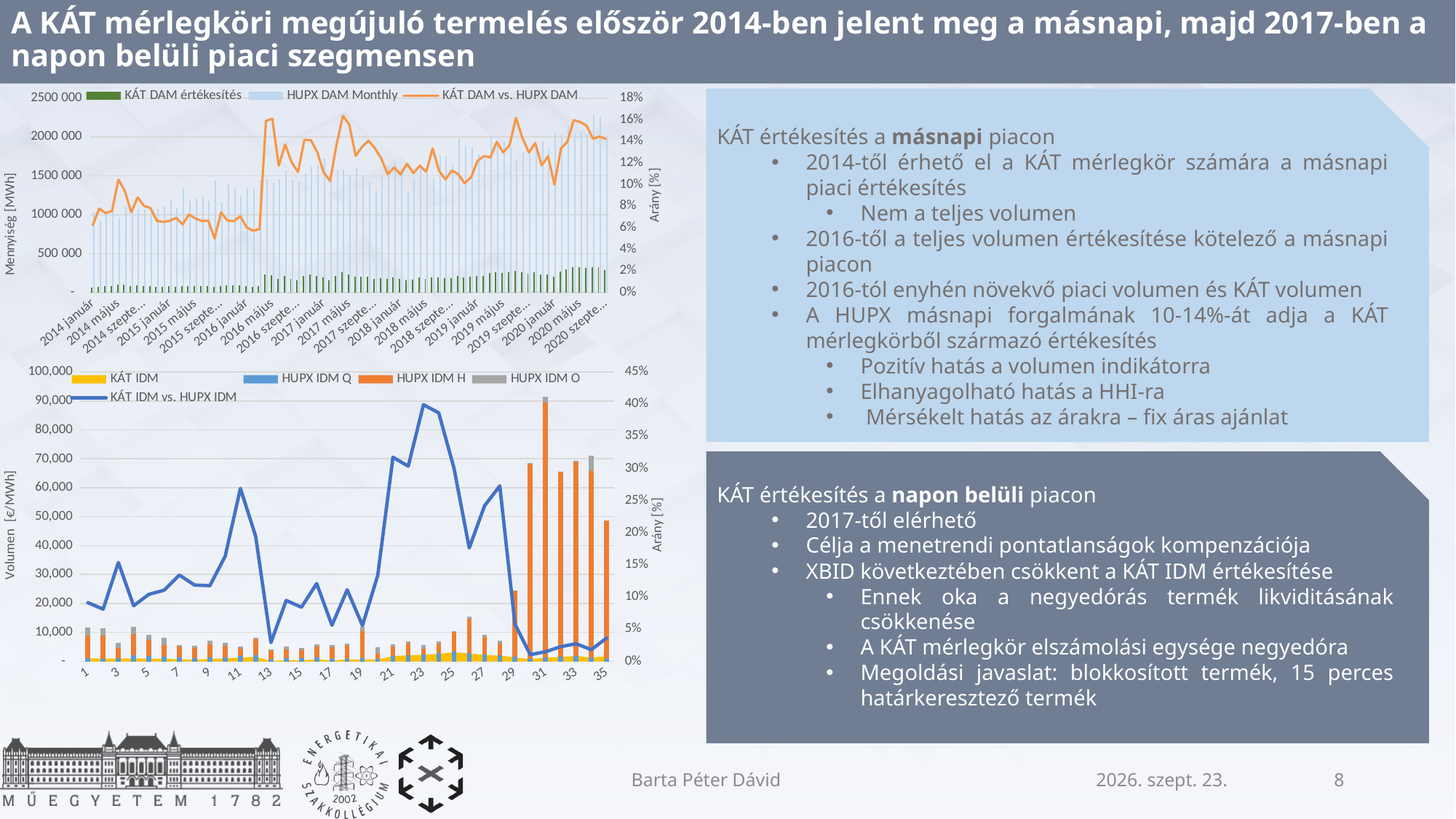
On the bottom chart, at which x-axis point is the HUPX IDM H bar highest? 31 On the top chart, which is larger, the KÁT DAM vs. HUPX DAM value for 2015 május or for 2016 május? 2016 május On the top chart, what is the title of the left vertical axis? Mennyiség [MWh] On the bottom chart, is the KÁT IDM vs. HUPX IDM value at point 23 greater or less than 35%? greater On the bottom chart, how many series does the legend list? 5 What kind of chart is the bottom chart? Combined area, bar and line chart On the top chart, how many series does the legend list? 3 On the top chart, is the KÁT DAM vs. HUPX DAM value for 2014 január greater or less than 8%? less On the top chart, is the KÁT DAM vs. HUPX DAM value for 2017 május greater or less than 14%? greater On the bottom chart, what is the title of the left vertical axis? Volumen [€/MWh] What kind of chart is the top chart? Combined bar and line chart